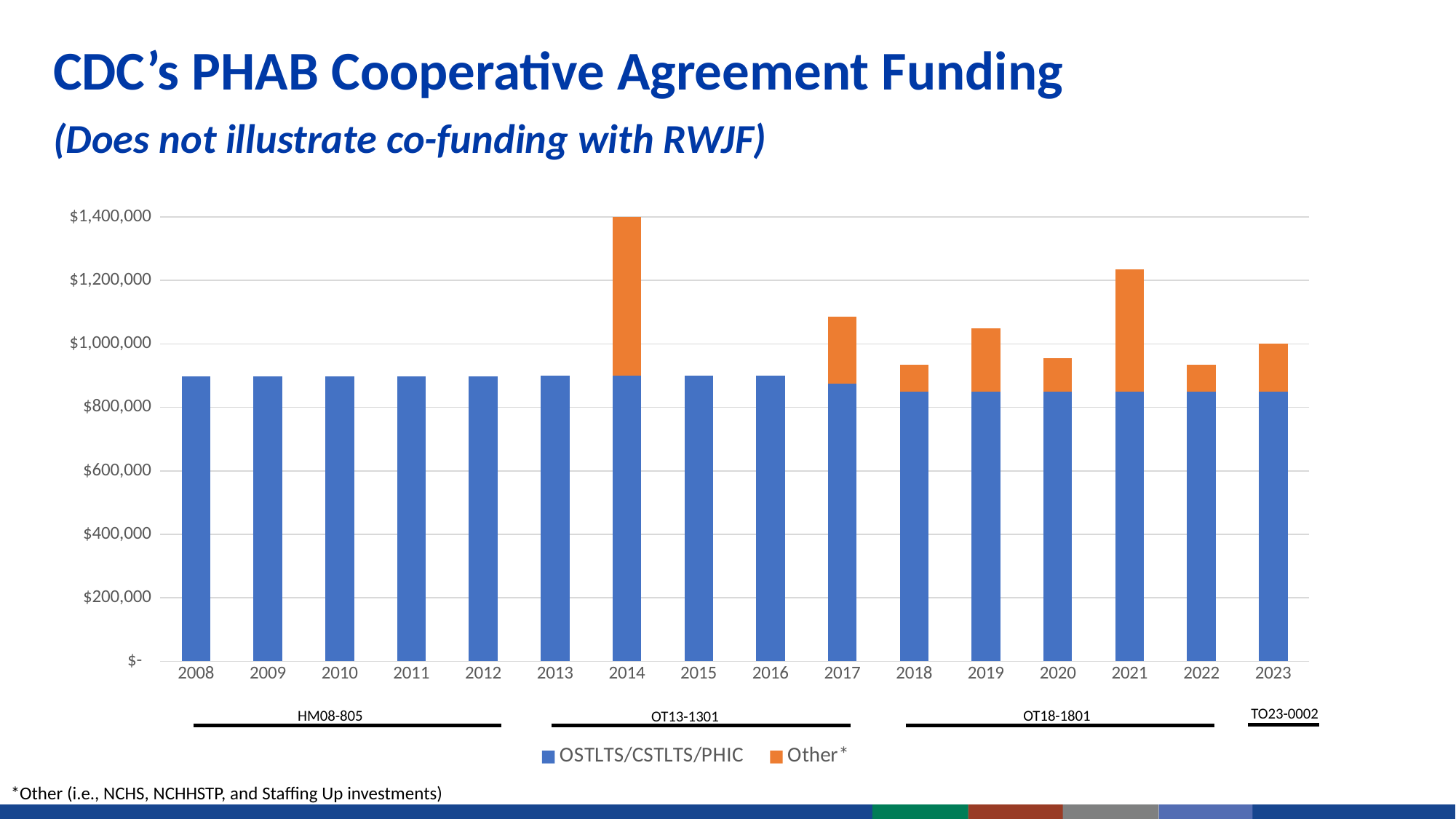
Which year has the larger total funding, 2014 or 2021? 2014 How many years are shown on the x axis of the chart? 16 What kind of chart is shown on the slide? Stacked bar chart What are the two series named in the chart's legend? OSTLTS/CSTLTS/PHIC and Other* Is the total funding for 2017 greater or less than $1,000,000? greater How many series does the chart's legend list? 2 Which is the first year in the chart to show an orange 'Other' segment? 2014 Is the total funding for 2008 greater or less than $1,000,000? less Is the total funding for 2021 greater or less than $1,200,000? greater Which year has the highest total funding in the chart? 2014 Which year has the larger total funding, 2019 or 2020? 2019